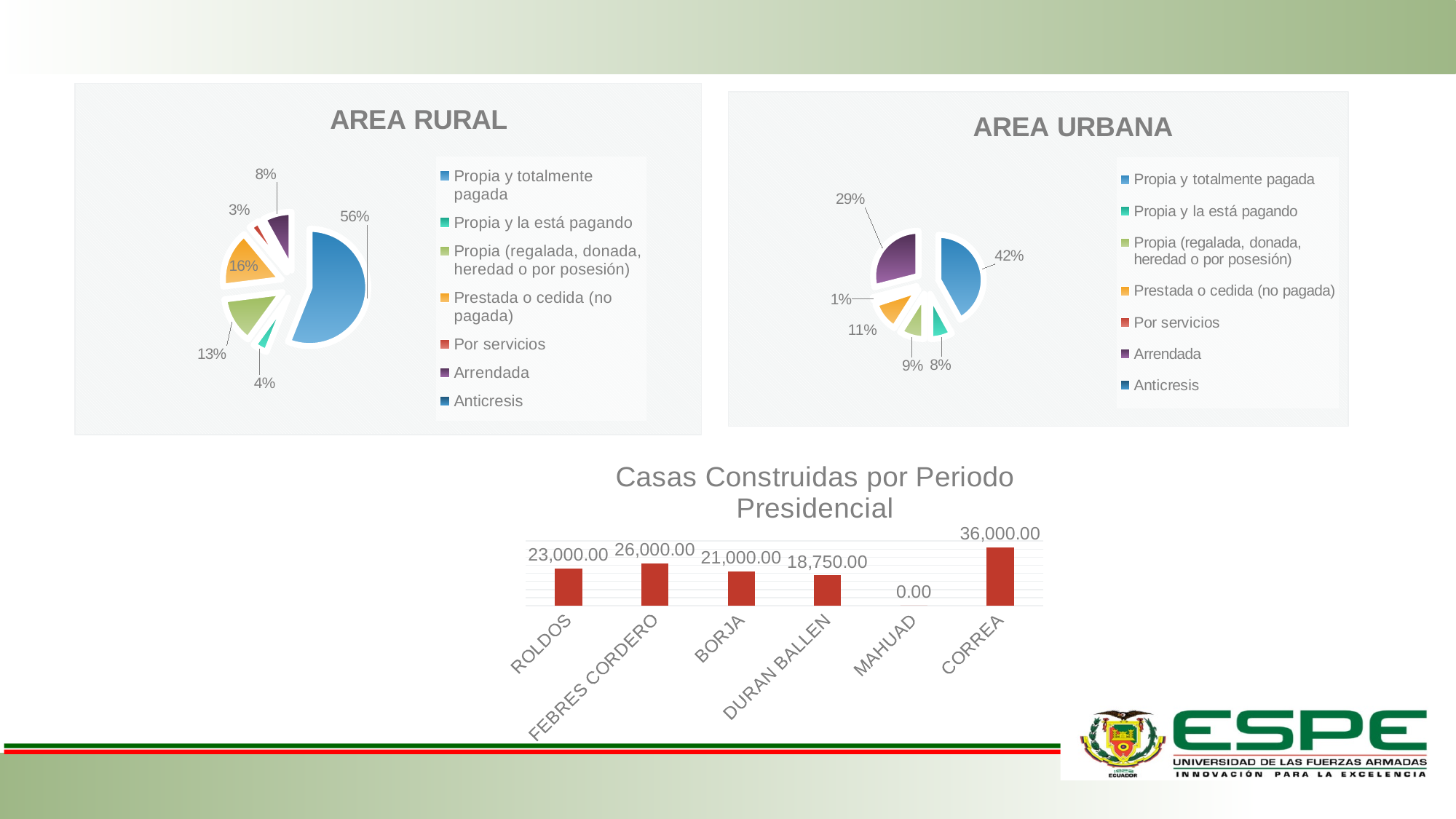
In the AREA URBANA pie chart, what percentage is shown for the purple slice (Arrendada)? 29% How many entries does the legend of the AREA URBANA chart list? 7 In the 'Casas Construidas por Periodo Presidencial' chart, which presidential period has the lowest value? MAHUAD In the AREA RURAL pie chart, what percentage is shown for the purple slice (Arrendada)? 8% In the AREA RURAL pie chart, what share is labelled for the largest slice (Propia y totalmente pagada)? 56% What kind of chart is 'Casas Construidas por Periodo Presidencial'? bar chart In the AREA URBANA pie chart, what is the smallest percentage shown? 1% In the 'Casas Construidas por Periodo Presidencial' chart, what is the difference between FEBRES CORDERO and ROLDOS? 3,000.00 In the 'Casas Construidas por Periodo Presidencial' chart, what is the value for CORREA? 36,000.00 In the AREA URBANA pie chart, what is the largest percentage shown? 42% In the AREA RURAL pie chart, what percentage is shown for the orange slice (Prestada o cedida)? 16% How many presidential periods are shown in the 'Casas Construidas por Periodo Presidencial' chart? 6